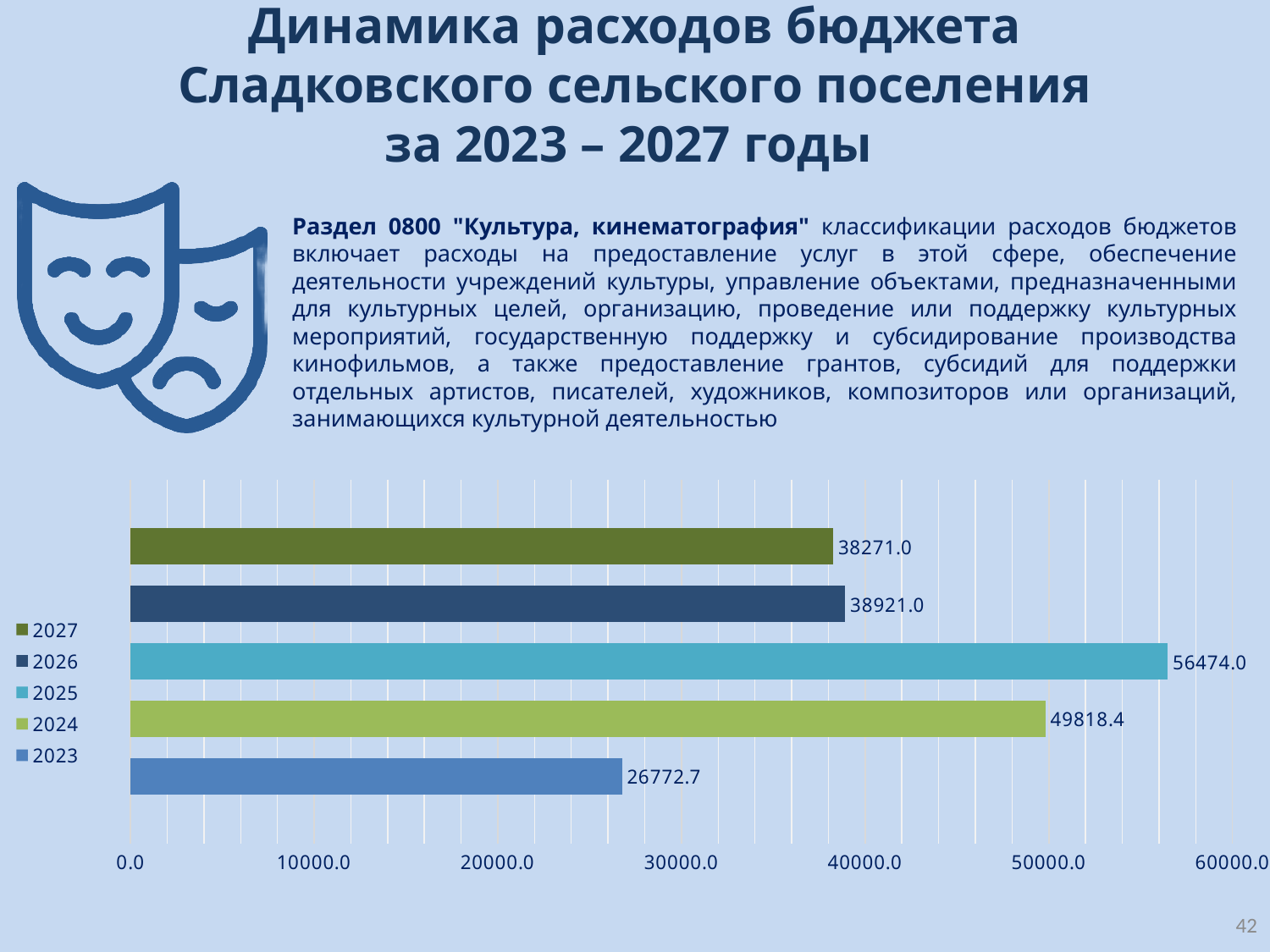
What is the difference between the values for 2025 and 2024? 6655.6 Which year has the highest value? 2025 Which year has the lowest value? 2023 How many bars are plotted in the chart? 5 What is the value for 2027? 38271.0 How many entries does the legend list? 5 What is the value for 2024? 49818.4 Which is larger, the value for 2024 or the value for 2023? 2024 What kind of chart is shown on the slide? bar chart What is the value for 2025? 56474.0 What is the difference between the values for 2026 and 2027? 650.0 What is the value for 2023? 26772.7